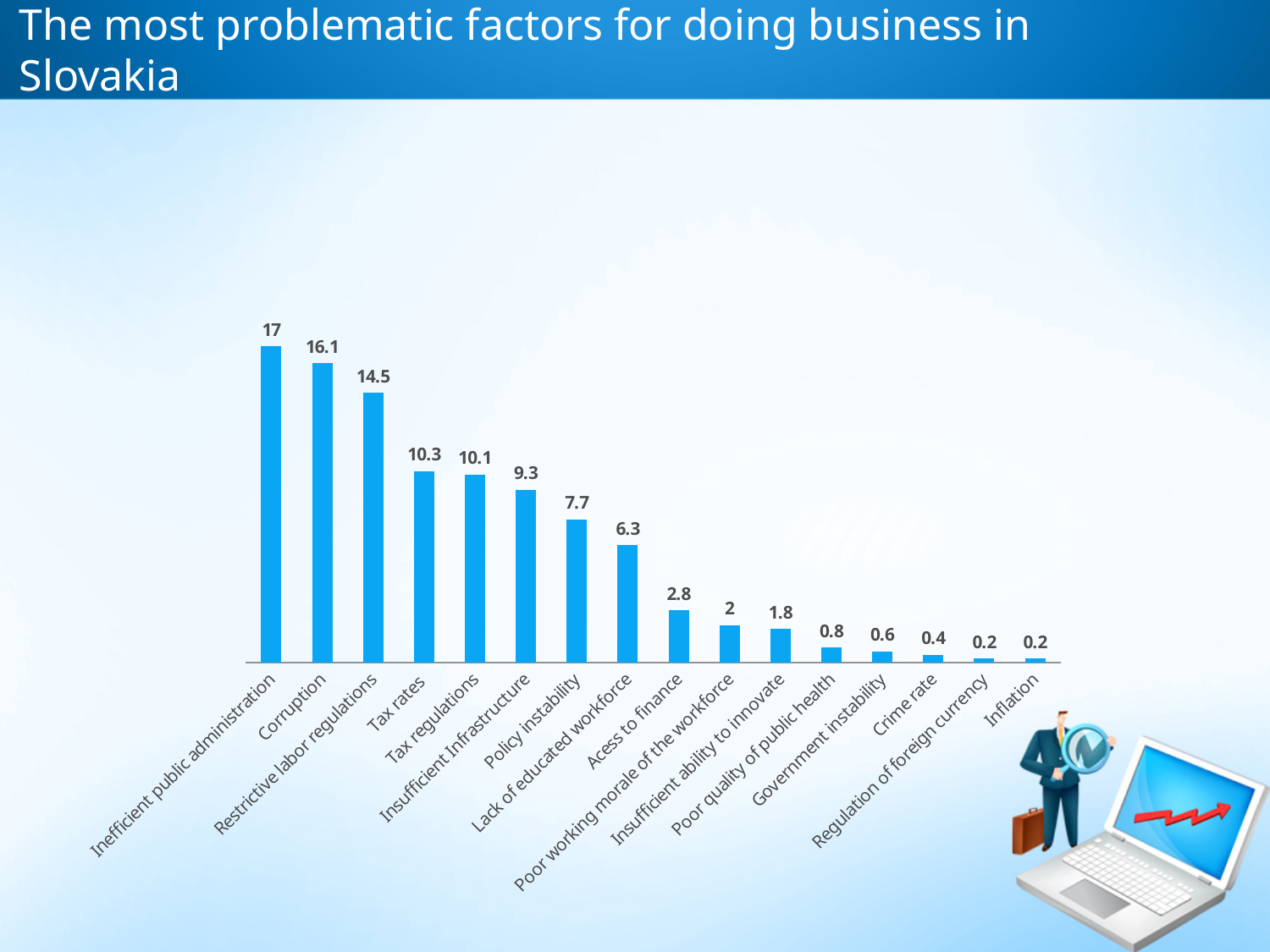
What is the value for Policy instability? 7.7 Do the values rise or fall from left to right along the x axis? Fall How many categories are shown in the chart? 16 Which is larger, the value for Insufficient Infrastructure or the value for Lack of educated workforce? Insufficient Infrastructure What is the difference between the values for Inefficient public administration and Corruption? 0.9 What is the value for Corruption? 16.1 What is the value for Crime rate? 0.4 Which category has the highest value? Inefficient public administration What is the value for Tax rates? 10.3 What is the difference between the values for Tax rates and Tax regulations? 0.2 What is the value for Acess to finance? 2.8 What kind of chart is shown on the slide? Bar chart